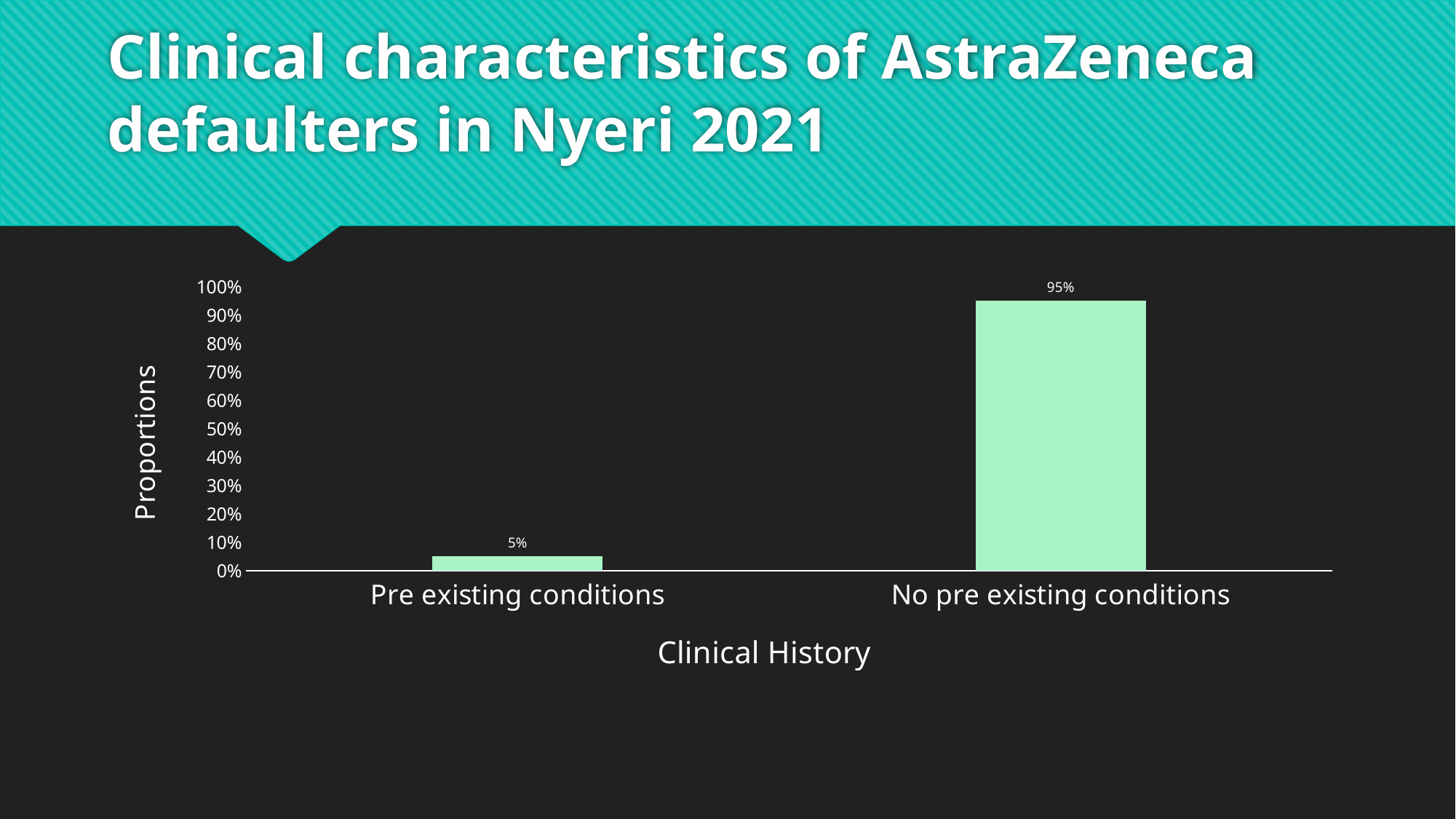
Is the value for No pre existing conditions greater or less than 50%? greater Is the value for Pre existing conditions greater or less than 10%? less What kind of chart is shown on the slide? bar chart Which is larger, the value for Pre existing conditions or the value for No pre existing conditions? No pre existing conditions What is the difference between the values for No pre existing conditions and Pre existing conditions? 90% What is the label of the y axis? Proportions What is the value for Pre existing conditions? 5% How many categories are shown on the x axis? 2 Which category has the lowest value? Pre existing conditions What is the label of the x axis? Clinical History What is the value for No pre existing conditions? 95% Which category has the highest value? No pre existing conditions